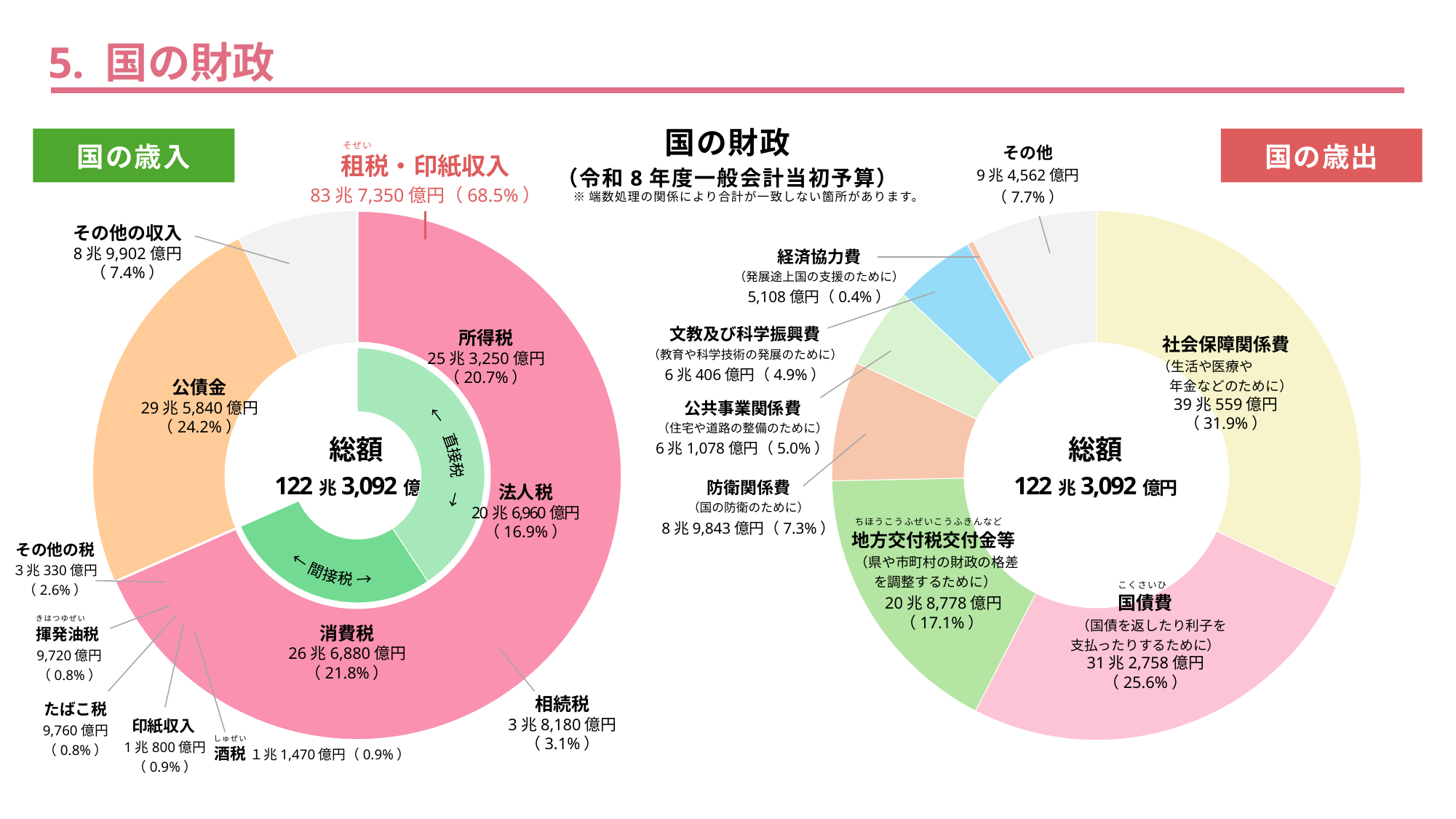
「国の歳入」のグラフで、租税・印紙収入の割合は何％ですか？ 68.5% 「国の歳出」のグラフで、最も割合が小さい項目は何ですか？ 経済協力費 「国の歳出」のグラフで、最も割合が大きい項目は何ですか？ 社会保障関係費 「国の歳出」のグラフで、国債費の金額はいくらですか？ 31兆2,758億円 「国の歳入」のグラフで、公債金の金額はいくらですか？ 29兆5,840億円 「国の歳出」のグラフで、防衛関係費と公共事業関係費ではどちらの割合が大きいですか？ 防衛関係費 このスライドの2つのグラフはどのような種類のグラフですか？ 円グラフ（ドーナツグラフ） 「国の歳入」のグラフで、所得税と法人税の割合の差は何ポイントですか？ 3.8ポイント 「国の歳入」のグラフで、所得税と法人税ではどちらの金額が大きいですか？ 所得税 「国の歳入」のグラフで、消費税の割合は何％ですか？ 21.8% 「国の歳入」のグラフの総額はいくらですか？ 122兆3,092億円 「国の歳出」のグラフで、地方交付税交付金等の割合は何％ですか？ 17.1%